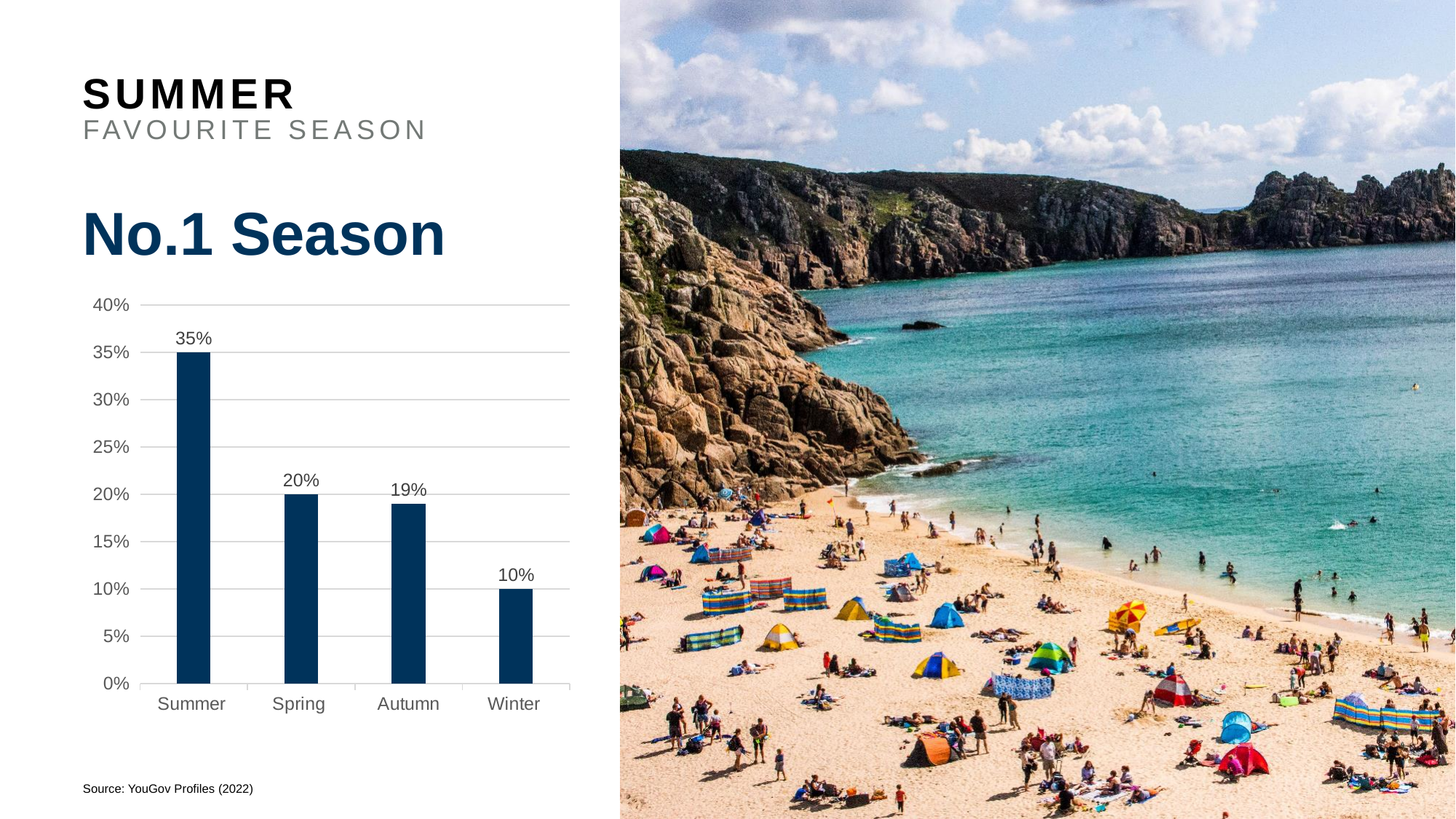
How many seasons are shown on the x axis of the chart? 4 What is the difference between the values for Spring and Autumn? 1% What is the value shown for Winter? 10% What is the difference between the values for Summer and Winter? 25% What is the value shown for Autumn? 19% What percentage of respondents chose Summer as their favourite season? 35% Which season has the highest value in the chart? Summer What is the source cited for the chart data? YouGov Profiles (2022) What type of chart is shown on the slide? Bar chart Which season has the lowest value in the chart? Winter Which has a larger value, Summer or Spring? Summer What is the value shown for Spring? 20%